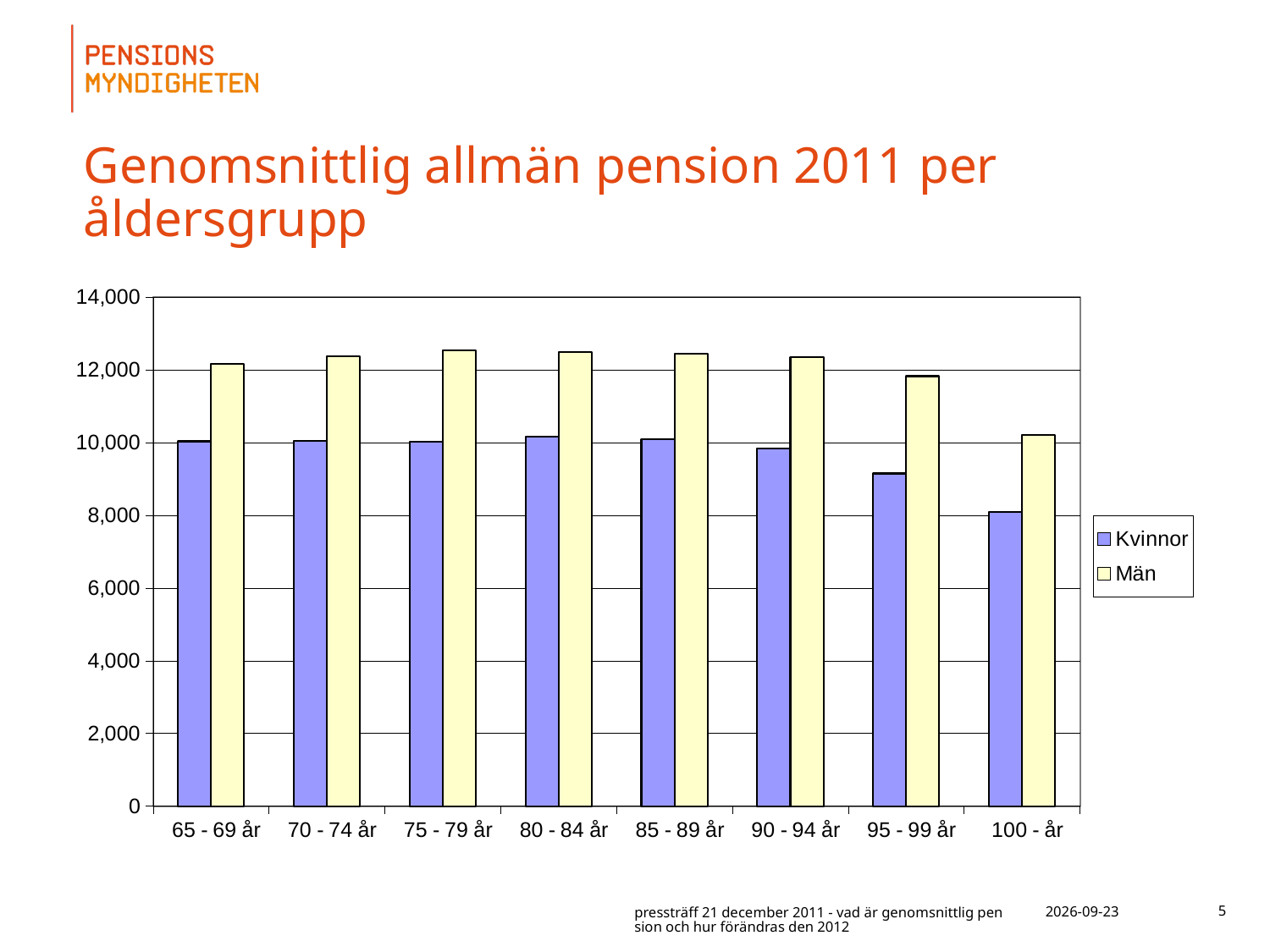
What kind of chart is shown on the slide? bar chart Is the value for Män in the 75 - 79 år group greater or less than 12,000? greater In the 80 - 84 år group, which is larger, the value for Kvinnor or for Män? Män For Kvinnor, which is larger, the value for 95 - 99 år or for 100 - år? 95 - 99 år What are the two entries in the chart legend? Kvinnor and Män Is the value for Kvinnor in the 95 - 99 år group greater or less than 10,000? less How many series does the legend list? 2 Do the Kvinnor values rise or fall from 85 - 89 år to 100 - år? fall Which age group has the lowest value for Män? 100 - år Which age group has the lowest value for Kvinnor? 100 - år Is the value for Män in the 95 - 99 år group greater or less than 12,000? less How many age groups are shown on the x axis? 8